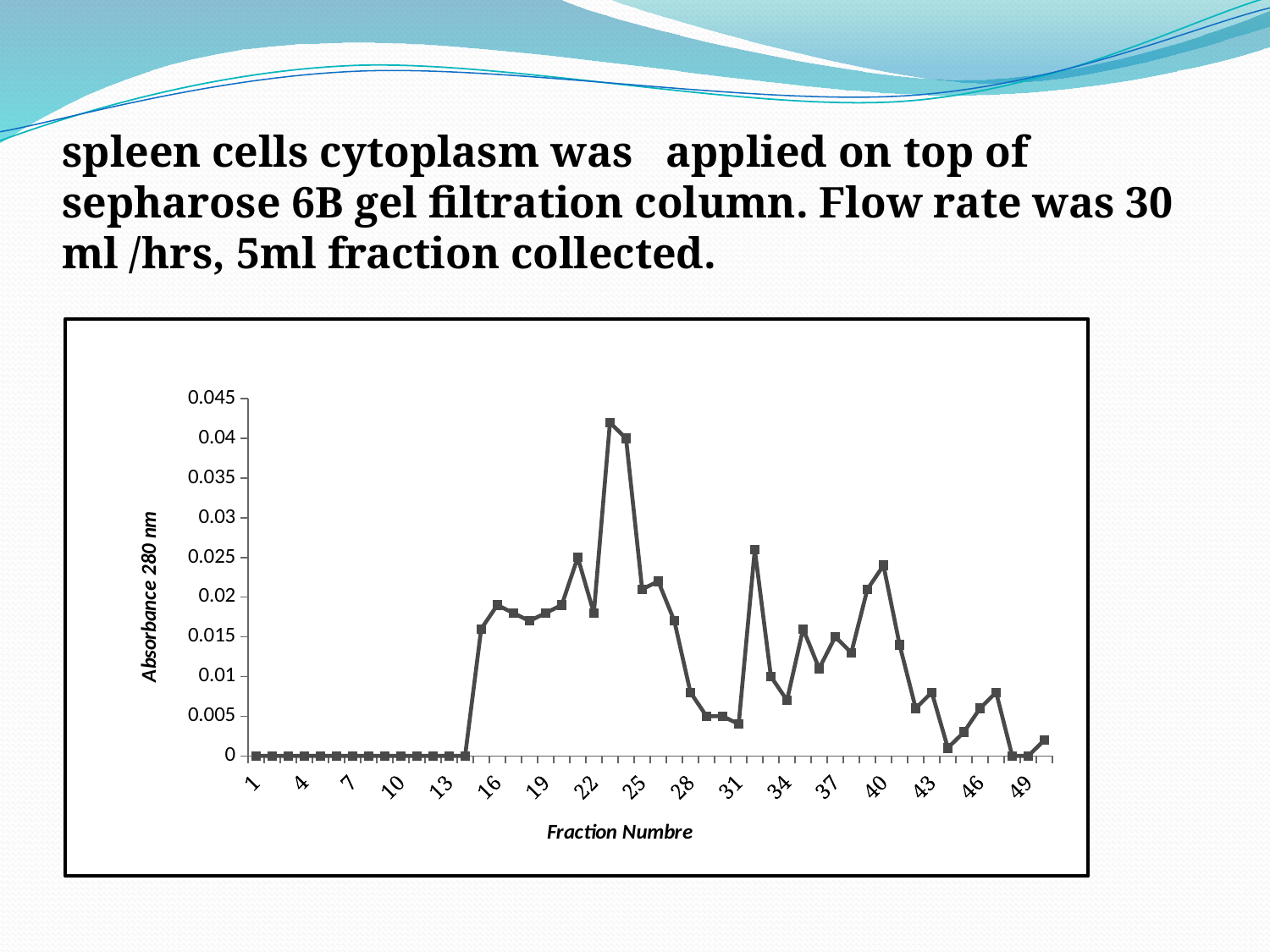
Do the absorbance values rise or fall between fraction 24 and fraction 31? fall At which fraction number does the absorbance reach its highest value? 23 What is the title of the x axis of the chart? Fraction Numbre Which fraction has the higher absorbance, fraction 40 or fraction 28? fraction 40 Which fraction has the higher absorbance, fraction 23 or fraction 32? fraction 23 Is the absorbance value for fraction 23 greater or less than 0.035? greater Is the absorbance value for fraction 32 greater or less than 0.02? greater What is the title of the y axis of the chart? Absorbance 280 nm What is the absorbance value plotted for fraction 10? 0 Is the absorbance value for fraction 31 greater or less than 0.01? less What is the absorbance value plotted for fraction 1? 0 What kind of chart is shown on the slide? line chart